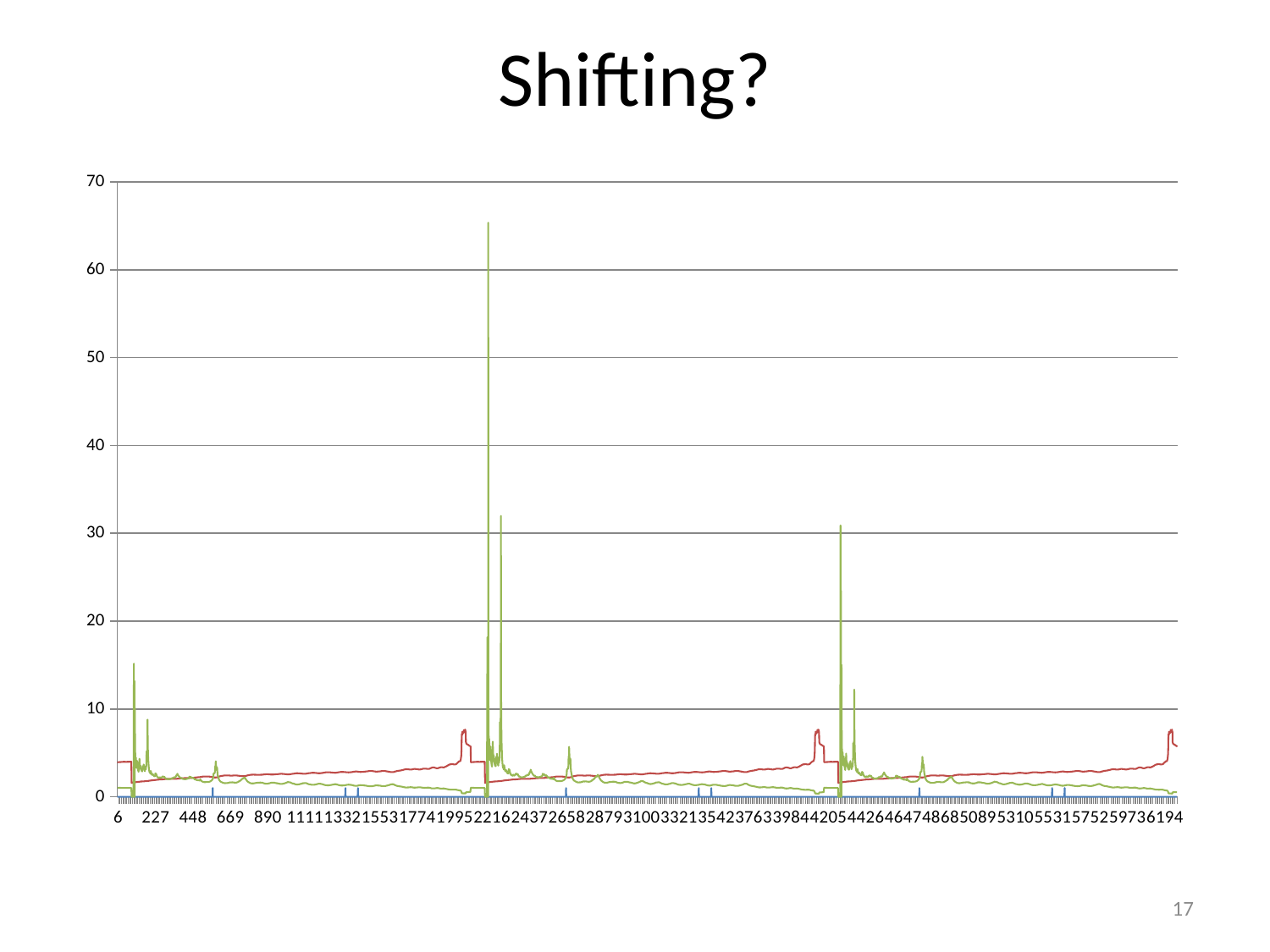
Is the first green spike near the left edge of the chart greater or less than 20? less Is the tallest spike of the green line greater or less than 70? less Is the tallest spike of the green line greater or less than 60? greater What is the highest value shown on the vertical axis of the chart? 70 What is the title of the chart? Shifting? What is the first label shown on the horizontal axis? 6 What kind of chart is shown on the slide? line chart Which line reaches the highest value on the chart, the red line or the green line? green